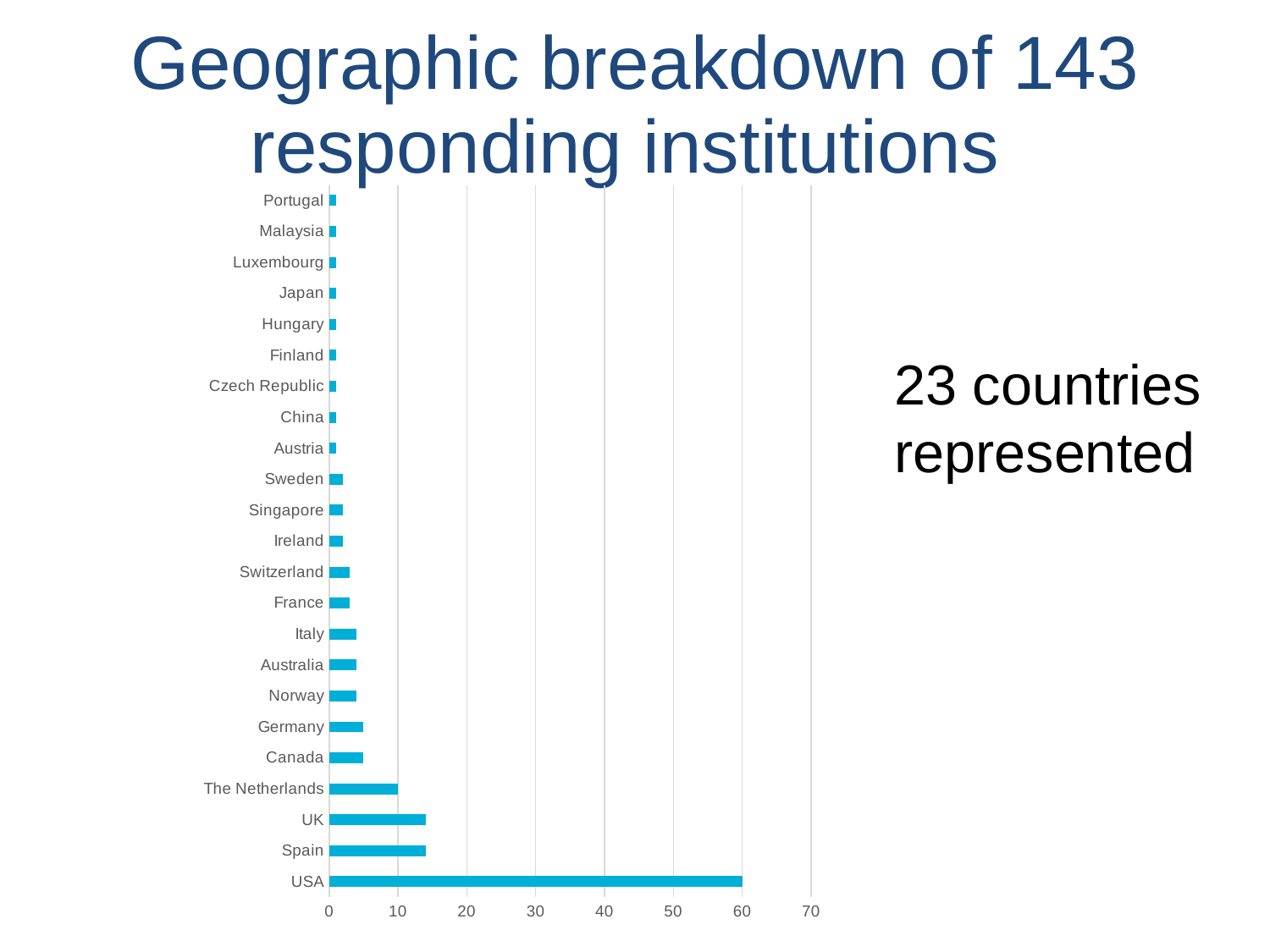
Which country has the highest number of responding institutions? USA Which is larger, the value for The Netherlands or the value for Canada? The Netherlands What kind of chart is shown on the slide? bar chart Is the value for Germany greater or less than 10? less Is the value for Spain greater or less than 20? less Which is larger, the value for USA or the value for Spain? USA What is the title of the slide containing the chart? Geographic breakdown of 143 responding institutions How many countries are plotted in the chart? 23 What is the value for USA? 60 Is the value for USA greater or less than 50? greater What is the value for The Netherlands? 10